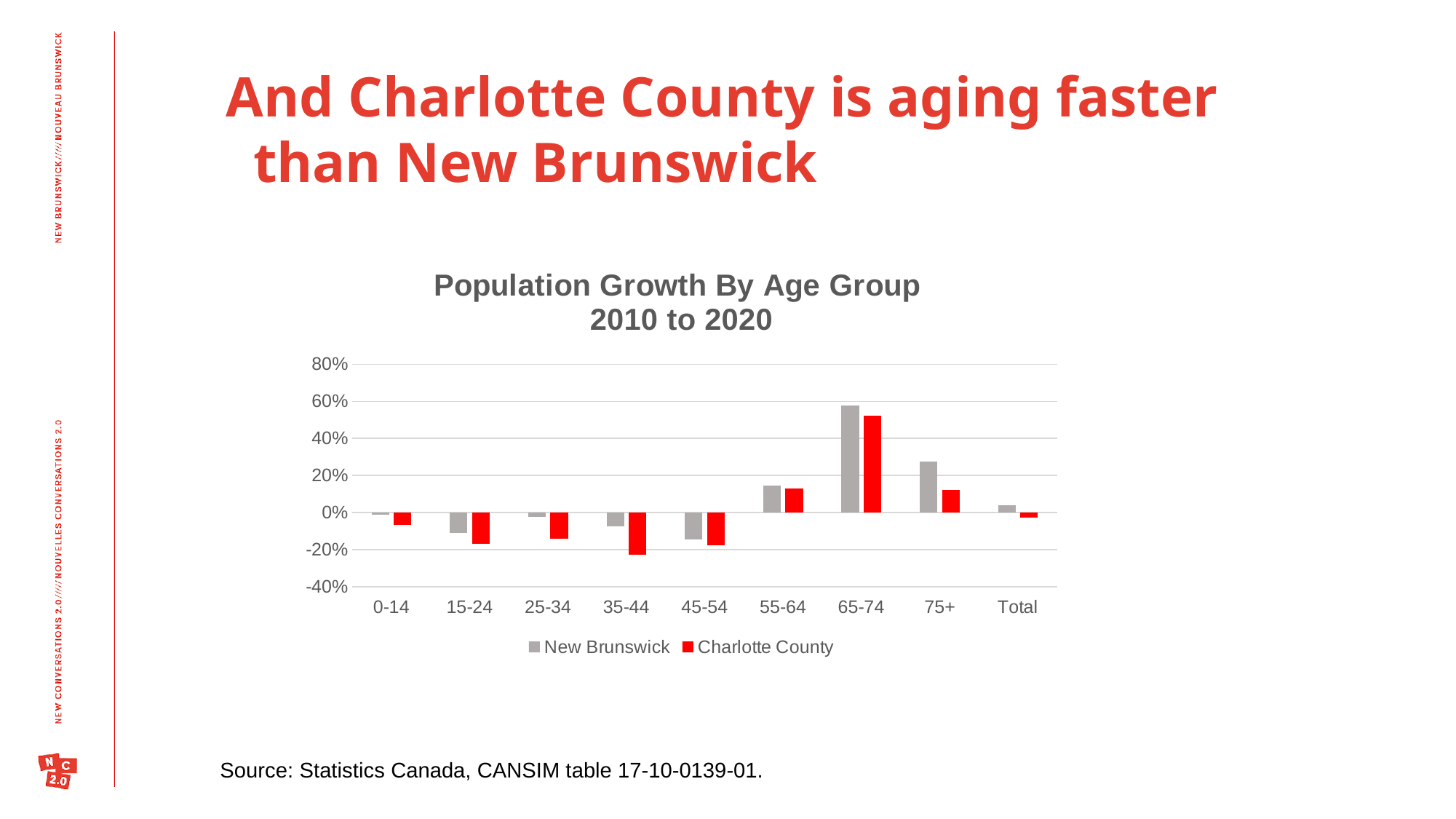
Which age group has the highest population growth for Charlotte County? 65-74 Which age group has the highest population growth for New Brunswick? 65-74 How many series does the legend list? 2 How many age-group categories are shown along the x axis, including Total? 9 Is the value for New Brunswick in the 65-74 age group greater or less than 40%? greater What is the title of the chart? Population Growth By Age Group 2010 to 2020 Which age group has the lowest population growth for Charlotte County? 35-44 Is the value for Charlotte County in the 35-44 age group greater or less than -20%? less What kind of chart is shown on the slide? Bar chart In the 75+ age group, which series has the larger value, New Brunswick or Charlotte County? New Brunswick Which age group has the lowest population growth for New Brunswick? 45-54 Is the value for New Brunswick in the 75+ age group greater or less than 20%? greater